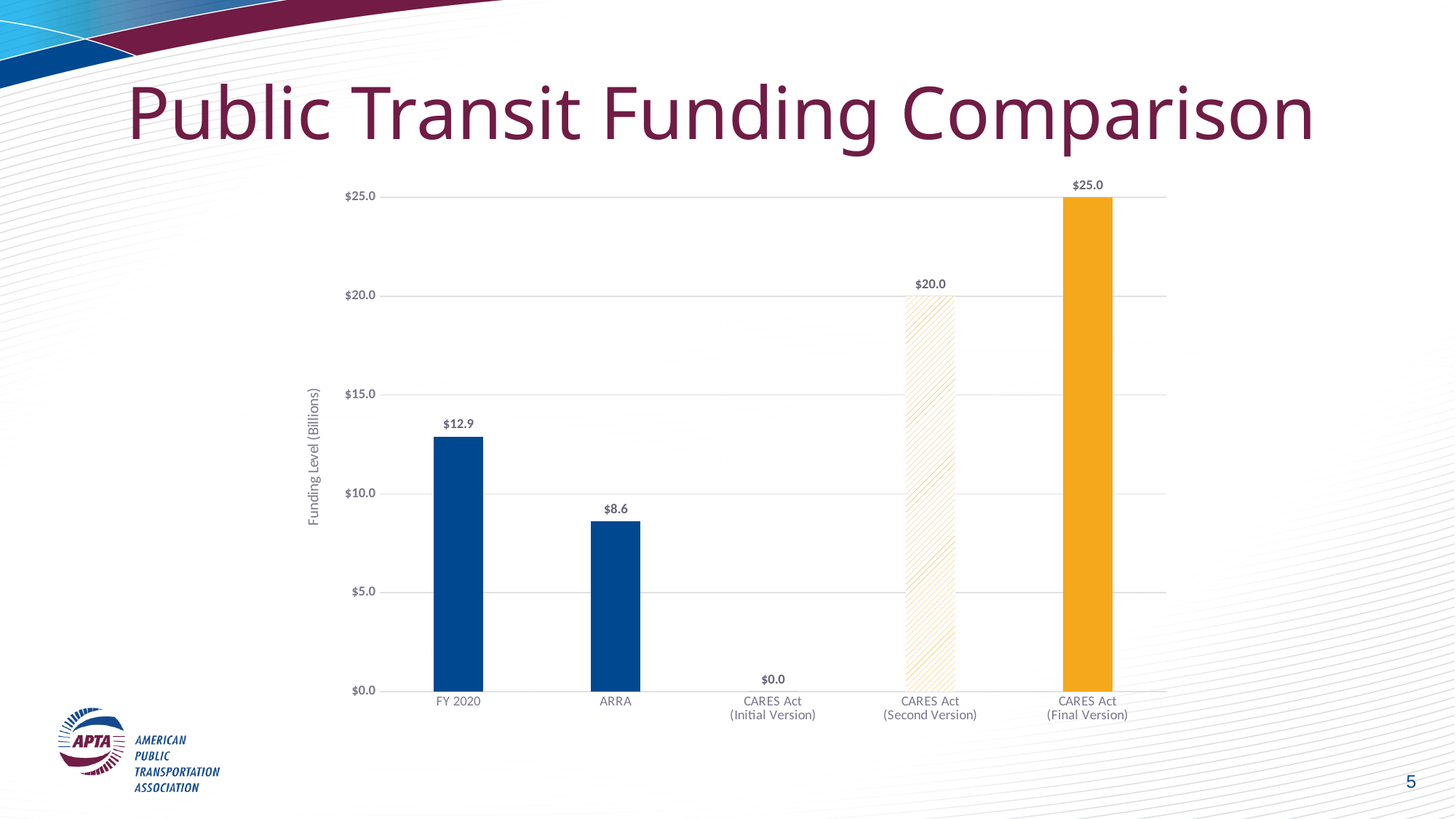
What is the difference between the FY 2020 and ARRA funding levels? $4.3 How many categories are shown on the x axis? 5 What is the funding level for FY 2020? $12.9 What is the difference between the CARES Act (Final Version) and the CARES Act (Second Version) funding levels? $5.0 What is the funding level for ARRA? $8.6 Which is larger, the funding level for FY 2020 or for ARRA? FY 2020 Which category has the lowest funding level? CARES Act (Initial Version) What is the funding level for the CARES Act (Second Version)? $20.0 Which category has the highest funding level? CARES Act (Final Version) What is the label of the vertical axis? Funding Level (Billions) What is the funding level for the CARES Act (Initial Version)? $0.0 What kind of chart is shown on the slide? Bar chart